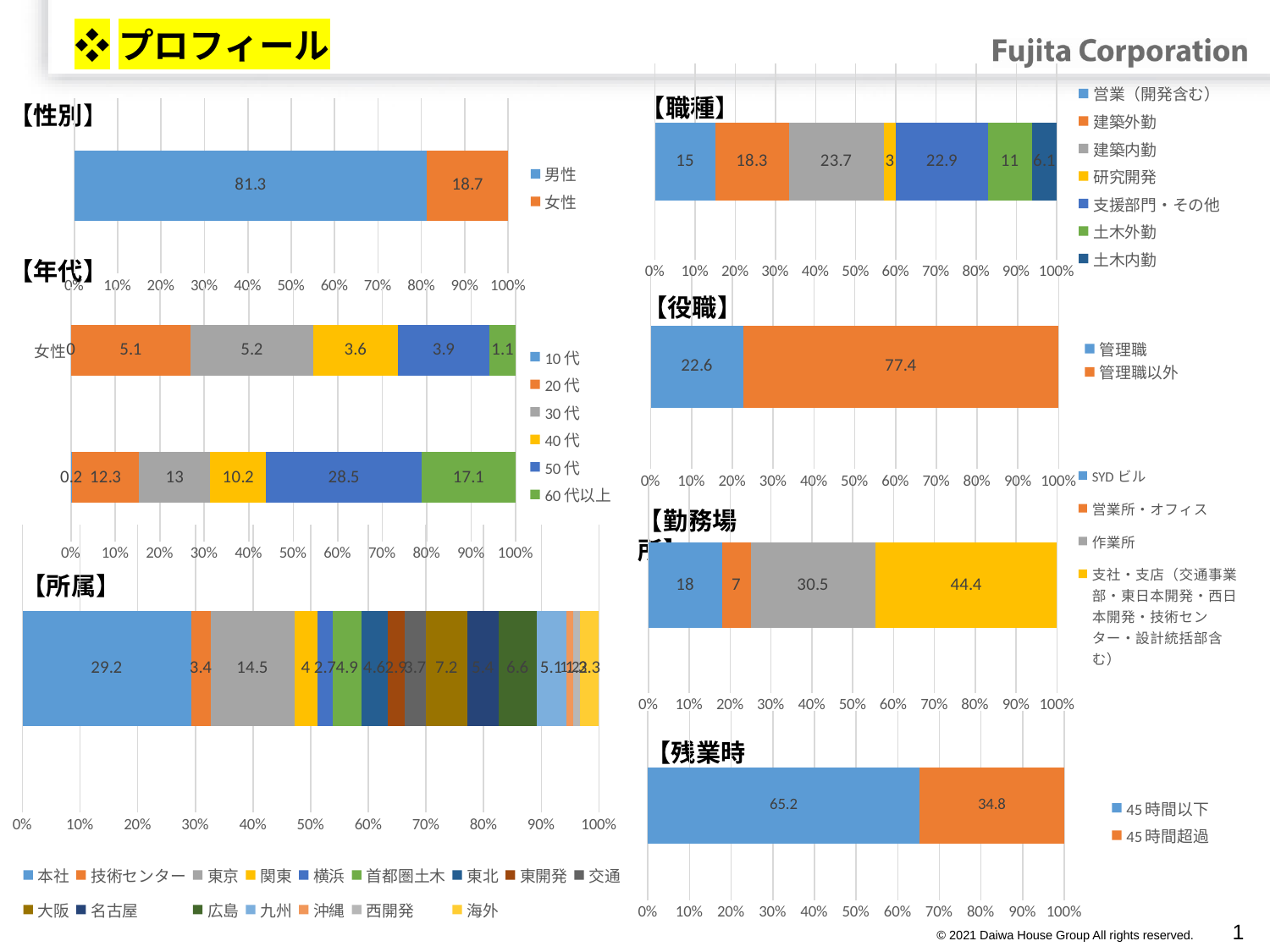
In the 【年代】 chart, how many series does the legend list? 6 In the 【職種】 chart, which job category has the smallest value? 研究開発 In the 【年代】 chart, what is the value of the 50代 segment in the lower bar? 28.5 In the 【職種】 chart, how many series does the legend list? 7 In the 【職種】 chart, what is the value for 建築内勤? 23.7 In the 【役職】 chart, what is the value for 管理職以外? 77.4 What kind of chart is the 【残業時間】 chart? bar chart In the 【年代】 chart, which age segment is the largest in the lower bar? 50代 In the 【性別】 chart, what is the value for 男性? 81.3 In the 【勤務場所】 chart, which category has the largest value? 支社・支店（交通事業部・東日本開発・西日本開発・技術センター・設計統括部含む） In the 【性別】 chart, what is the difference between the 男性 and 女性 values? 62.6 In the 【勤務場所】 chart, is the value for 作業所 larger or smaller than the value for SYDビル? larger